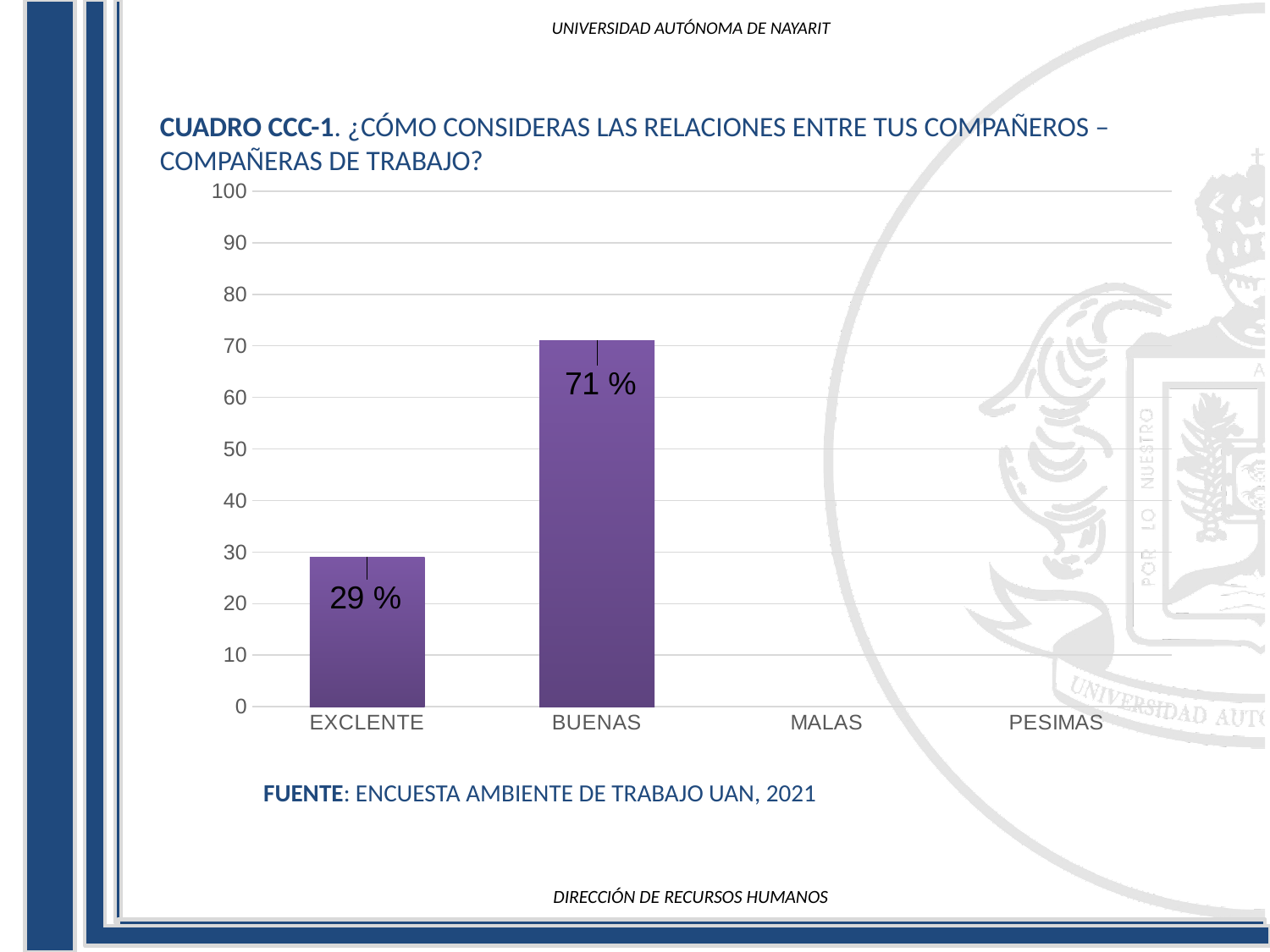
What is the value for BUENAS? 71 % What is the source cited below the chart? ENCUESTA AMBIENTE DE TRABAJO UAN, 2021 Is the value for EXCLENTE greater or less than 40? less What kind of chart is shown on the slide? bar chart What is the value for EXCLENTE? 29 % Which category has the highest value? BUENAS What is the difference between the values for BUENAS and EXCLENTE? 42 % What is the maximum value shown on the y axis? 100 Which is larger, the value for EXCLENTE or the value for BUENAS? BUENAS Is the value for BUENAS greater or less than 60? greater Which categories have no visible bar? MALAS and PESIMAS How many categories are shown on the x axis? 4